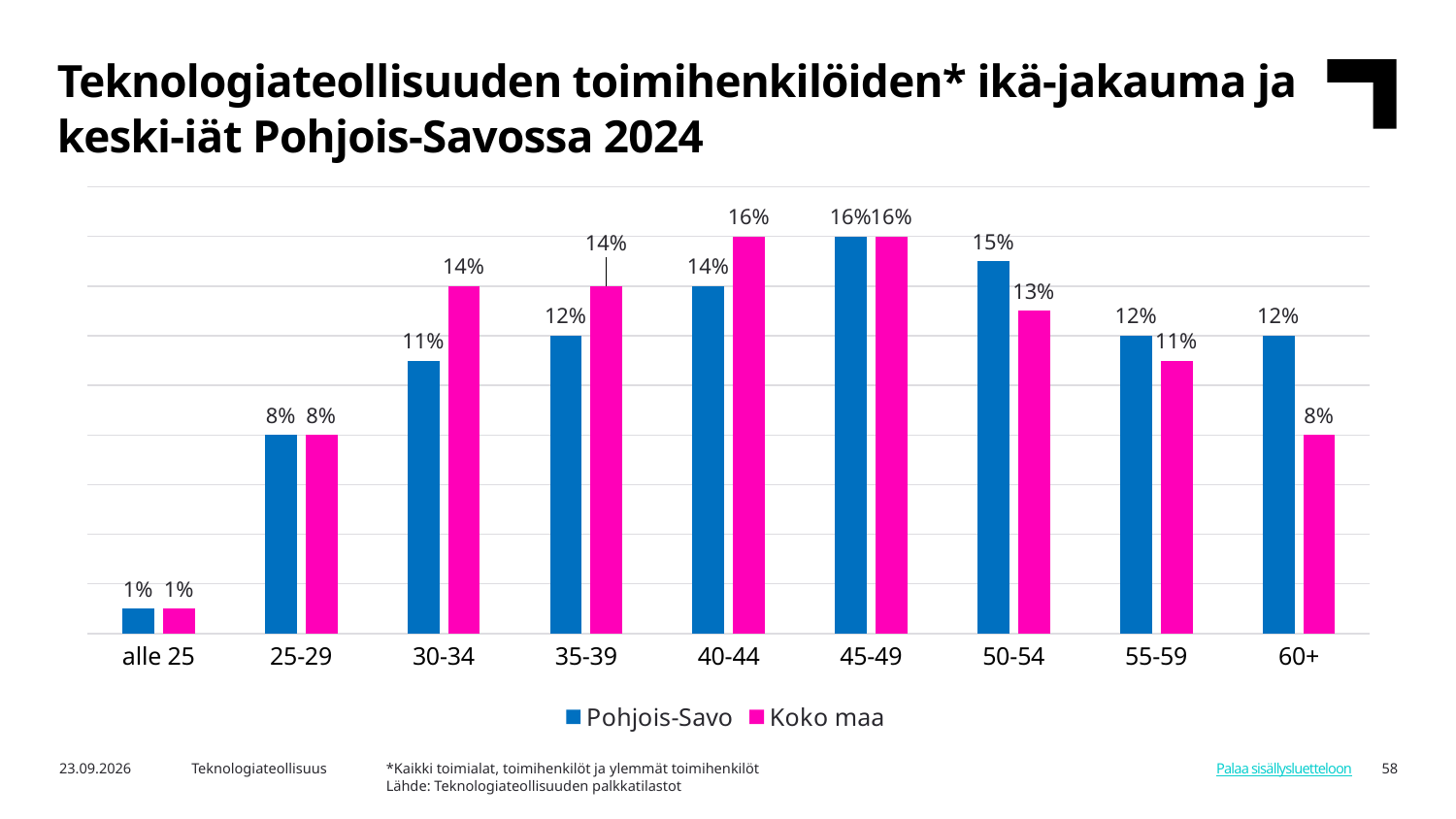
Which age group has the lowest value for Koko maa? alle 25 What is the value for Pohjois-Savo in the 30-34 age group? 11% What is the value for Koko maa in the 50-54 age group? 13% What kind of chart is shown on the slide? bar chart Which age group has the highest value for Pohjois-Savo? 45-49 Do the Koko maa values rise or fall from the 45-49 age group to the 60+ age group? fall What is the difference between the Koko maa and Pohjois-Savo values in the 30-34 age group? 3 percentage points How many age categories are shown on the x axis? 9 What is the value for Koko maa in the 60+ age group? 8% Which series is shown in pink in the chart? Koko maa How many series does the legend list? 2 In the 60+ age group, which series has the larger value, Pohjois-Savo or Koko maa? Pohjois-Savo